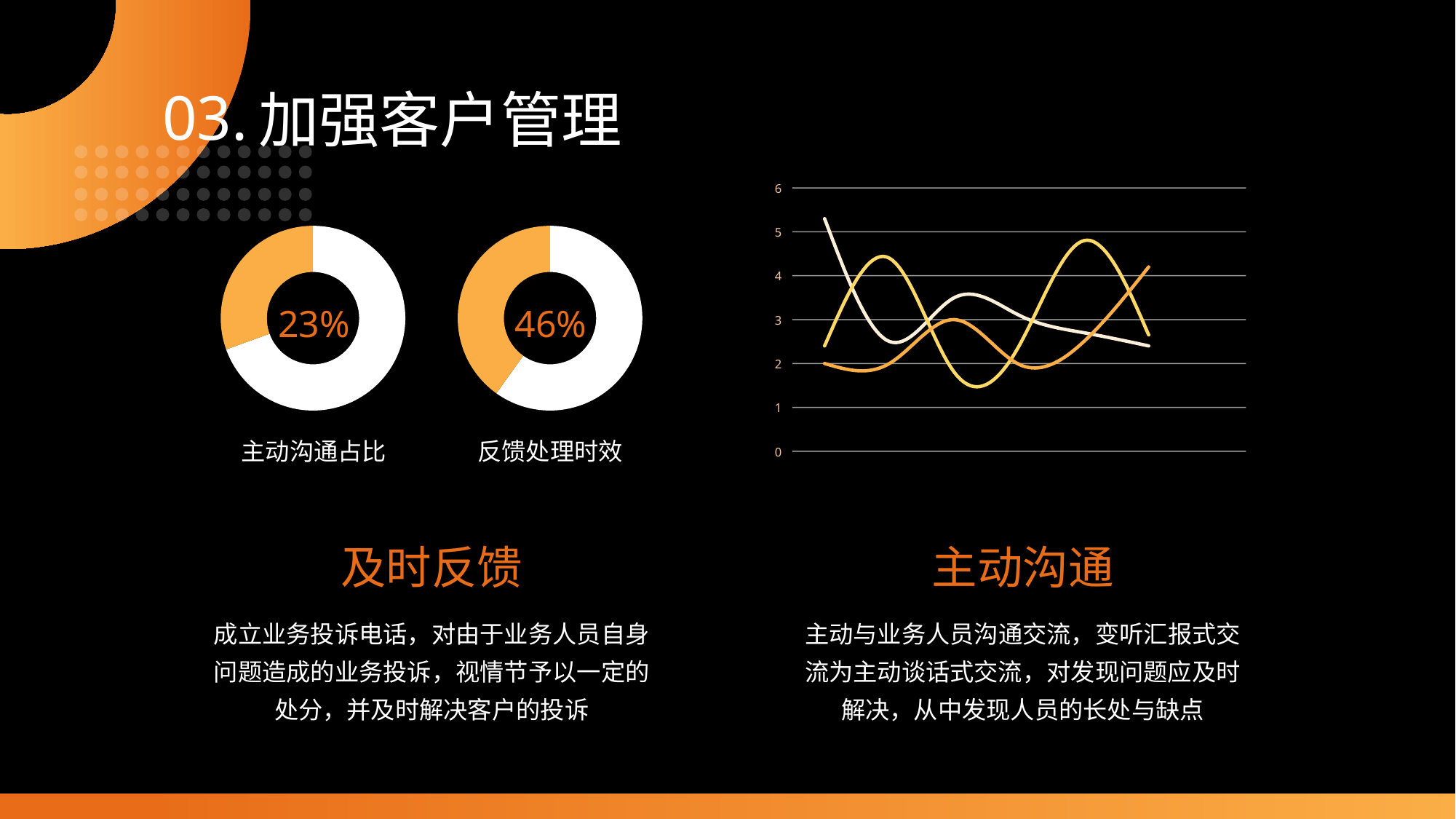
What value is shown in the centre of the donut chart labelled 反馈处理时效? 46% What kind of chart is used to display the 23% and 46% values on the left of the slide? Donut chart What is the highest tick value on the vertical axis of the line chart? 6 How many lines are plotted on the line chart on the right of the slide? 3 What colour is the filled portion of the donut charts on the slide? Orange Which of the two donut charts shows the larger percentage, 主动沟通占比 or 反馈处理时效? 反馈处理时效 What value is shown in the centre of the donut chart labelled 主动沟通占比? 23% How many donut charts are on the slide? 2 What kind of chart is shown on the right side of the slide? Line chart On the line chart, is the lowest point of the yellow line greater or less than 2? less What is the difference between the percentages shown in the 反馈处理时效 and 主动沟通占比 donut charts? 23% On the line chart, is the starting value of the lightest (pale) line greater or less than 5? greater